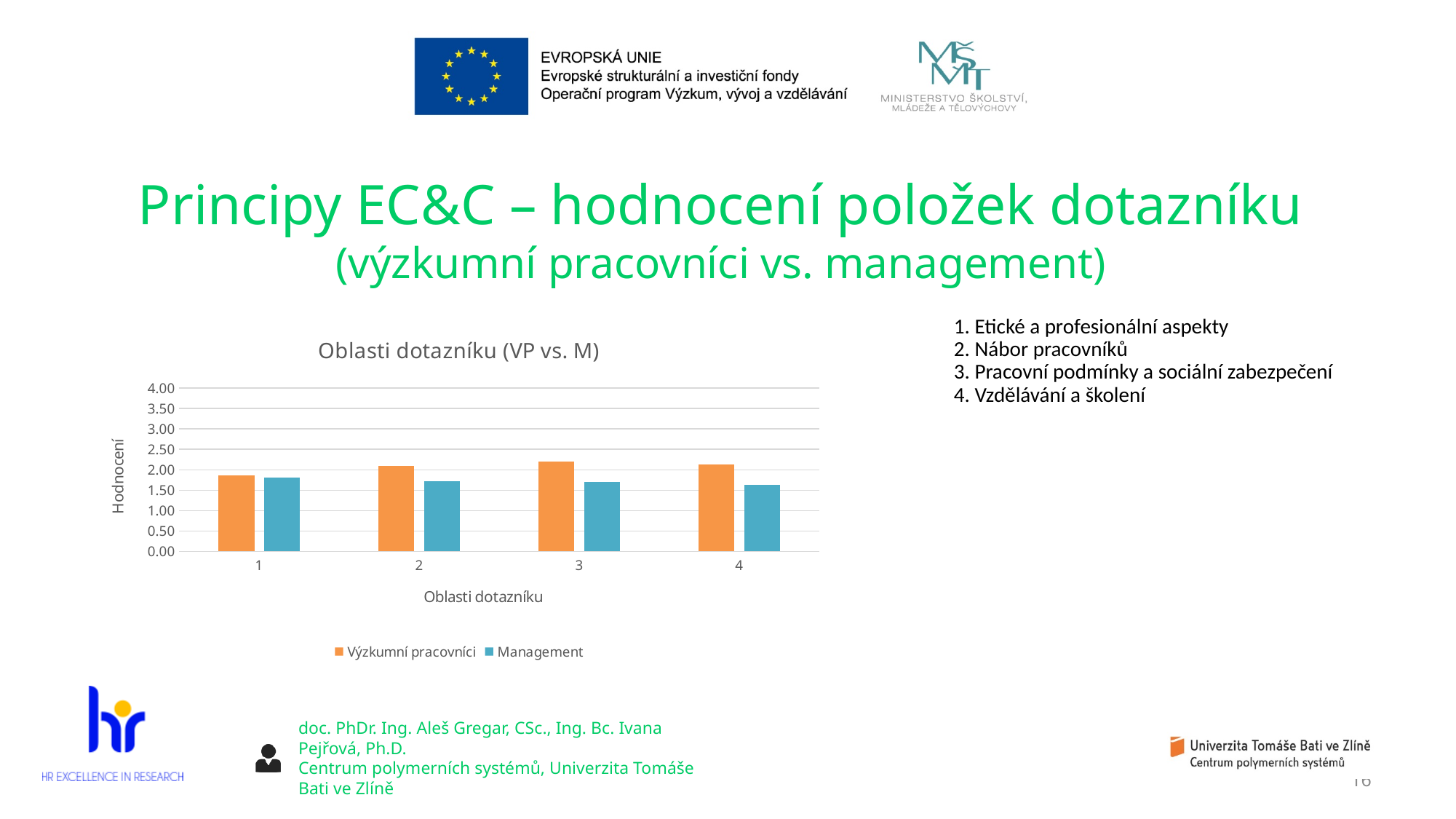
In category 4, which series has the larger value, Výzkumní pracovníci or Management? Výzkumní pracovníci Which series is shown in orange in the chart? Výzkumní pracovníci In category 3, which series has the larger value, Výzkumní pracovníci or Management? Výzkumní pracovníci How many categories are shown on the x axis of the chart? 4 Is the value for Management in category 2 greater or less than 1.50? greater For the Výzkumní pracovníci series, which category has the lowest value? 1 Is the value for Výzkumní pracovníci in category 3 greater or less than 2.00? greater How many series does the chart legend list? 2 What kind of chart is shown on the slide? bar chart Is the value for Management in category 4 greater or less than 2.00? less What is the title of the chart? Oblasti dotazníku (VP vs. M)